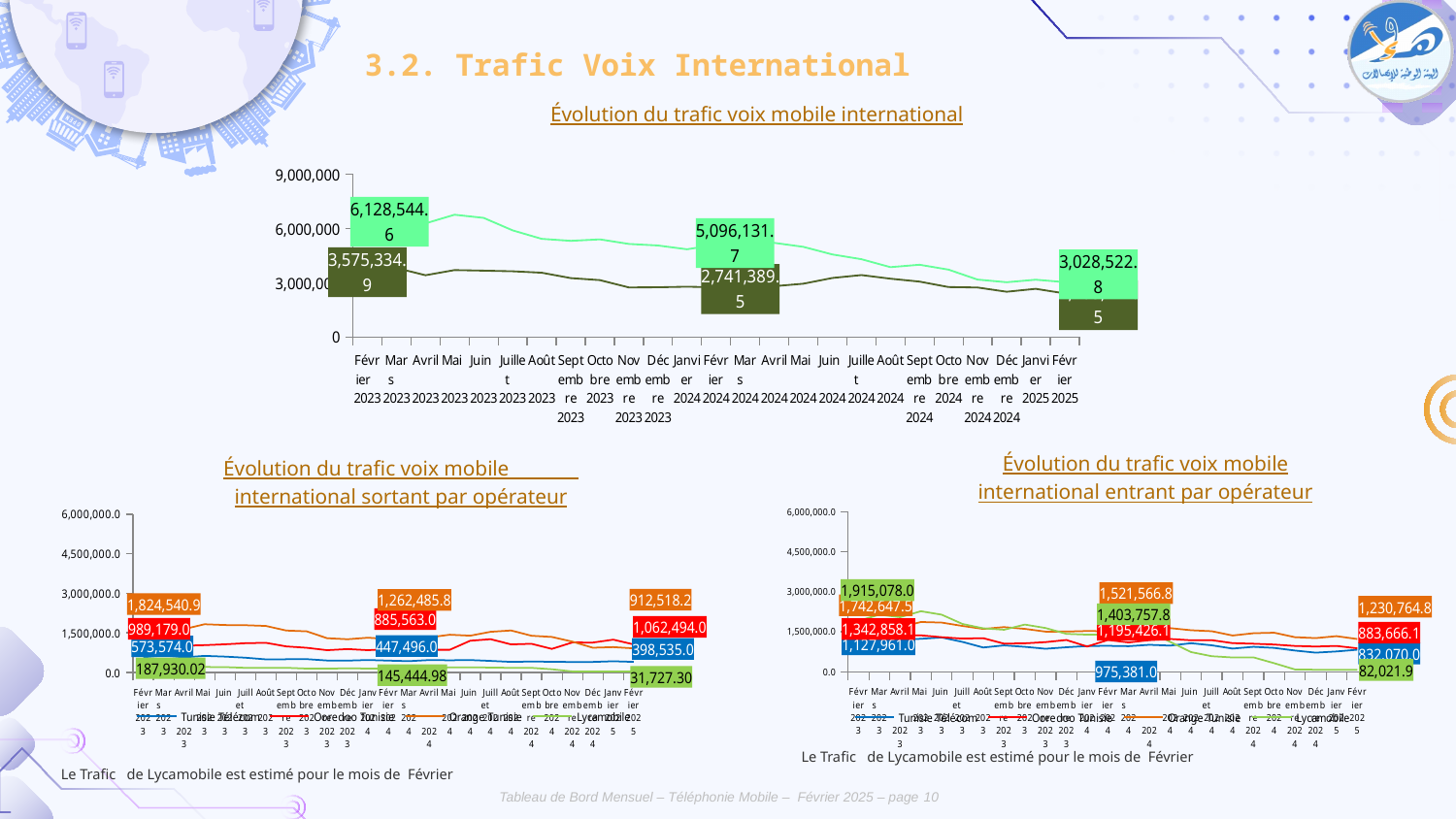
What kind of chart is the top chart titled 'Évolution du trafic voix mobile international'? Line chart In the bottom-left chart 'Évolution du trafic voix mobile international sortant par opérateur', what is the highest labelled value at Février 2023? 1,824,540.9 In the bottom-left chart 'Évolution du trafic voix mobile international sortant par opérateur', what is the lowest labelled value at Février 2025? 31,727.30 In the top chart 'Évolution du trafic voix mobile international', is the upper (light green) line's value at Février 2024 greater or less than 6,000,000? less In the top chart 'Évolution du trafic voix mobile international', what is the value labelled on the upper (light green) line at Février 2023? 6,128,544.6 How many series does the legend list in the bottom-left chart 'Évolution du trafic voix mobile international sortant par opérateur'? 4 In the bottom-right chart 'Évolution du trafic voix mobile international entrant par opérateur', what is the highest labelled value at Février 2023? 1,915,078.0 In the bottom-left chart 'Évolution du trafic voix mobile international sortant par opérateur', what is the difference between the two highest labelled values at Février 2025 (1,062,494.0 and 912,518.2)? 149,975.8 In the top chart 'Évolution du trafic voix mobile international', does the upper (light green) line rise or fall from Février 2023 to Février 2025? Fall In the bottom-right chart 'Évolution du trafic voix mobile international entrant par opérateur', what is the lowest labelled value at Février 2025? 82,021.9 In the top chart 'Évolution du trafic voix mobile international', what is the value labelled on the lower (dark green) line at Février 2024? 2,741,389.5 In the top chart 'Évolution du trafic voix mobile international', what is the difference between the two labelled values at Février 2023 (6,128,544.6 and 3,575,334.9)? 2,553,209.7